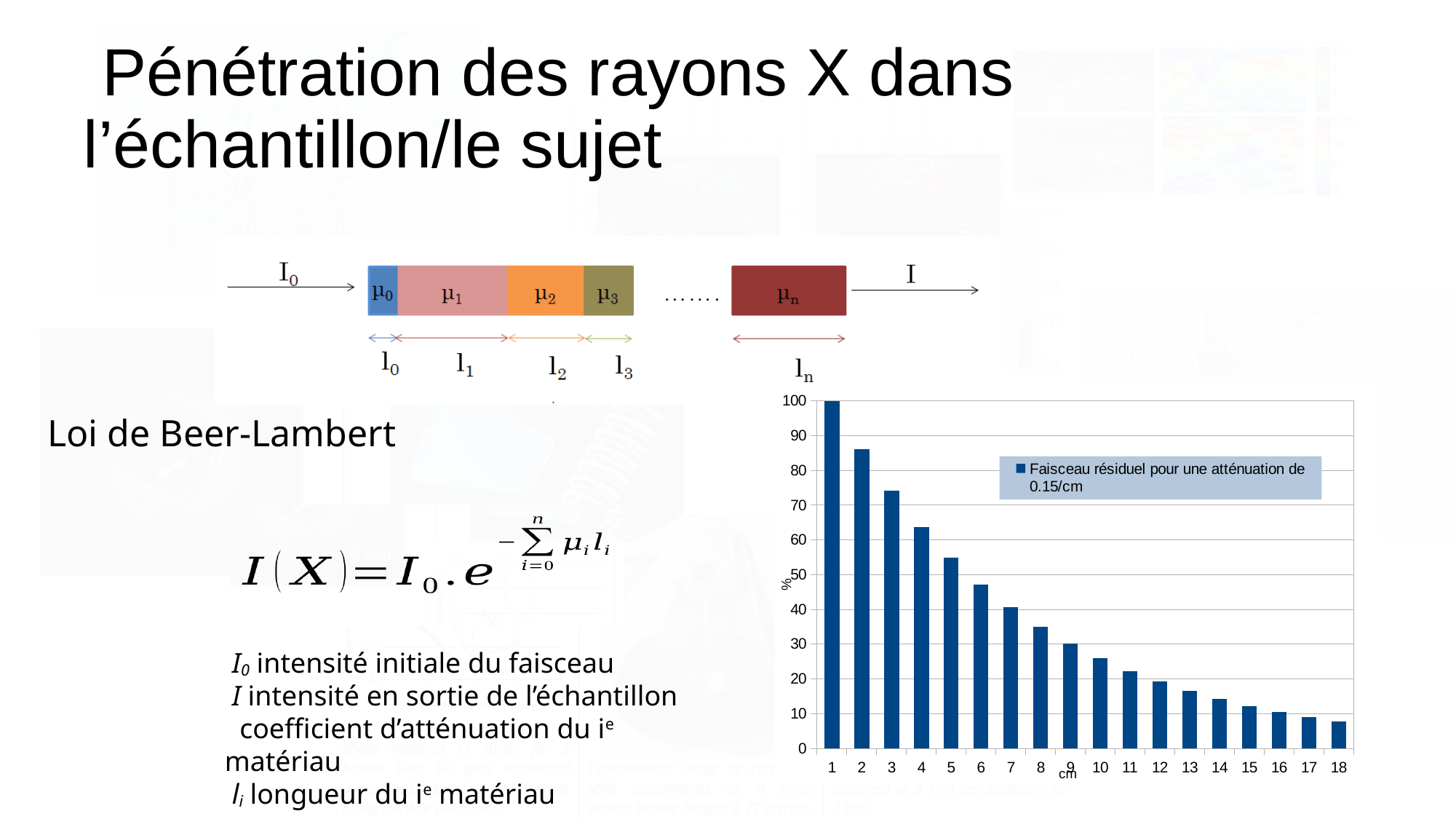
Which category on the x axis has the lowest bar? 18 Which category on the x axis has the highest bar? 1 Is the value for 10 cm greater or less than 30? less Do the bar values rise or fall as the x axis goes from 1 to 18? fall How many bars (categories) are plotted along the x axis of the chart? 18 What is the legend entry of the series plotted in the chart? Faisceau résiduel pour une atténuation de 0.15/cm Is the value for 3 cm greater or less than 70? greater How many series does the chart's legend list? 1 Is the value for 5 cm greater or less than 50? greater What kind of chart is shown on the slide? bar chart Which bar is taller, the one at 4 cm or the one at 12 cm? 4 cm What is the value (in %) of the bar at 1 cm? 100